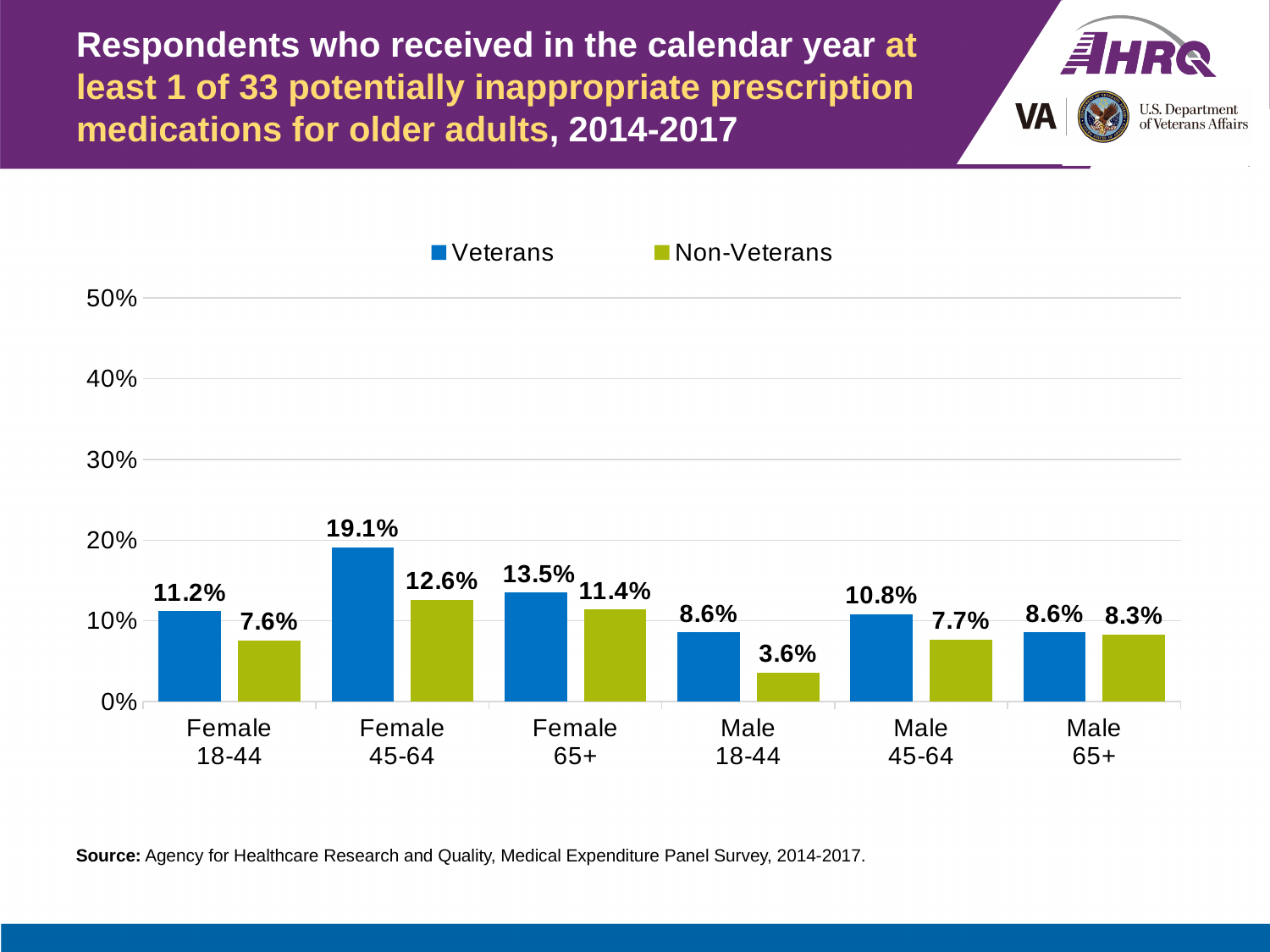
How many categories are shown on the x axis? 6 What is the difference between the Veterans and Non-Veterans values for Female 45-64? 6.5% What is the value for Veterans in the Female 45-64 category? 19.1% What kind of chart is shown on the slide? Bar chart Which is larger, the Veterans value for Female 18-44 or the Non-Veterans value for Female 45-64? Non-Veterans value for Female 45-64 Which category has the lowest Non-Veterans value? Male 18-44 What is the difference between the Veterans and Non-Veterans values for Male 18-44? 5.0% Which category has the highest Veterans value? Female 45-64 What colour are the Non-Veterans bars? Green What is the value for Non-Veterans in the Female 65+ category? 11.4% How many series does the legend list? 2 What is the value for Non-Veterans in the Male 18-44 category? 3.6%